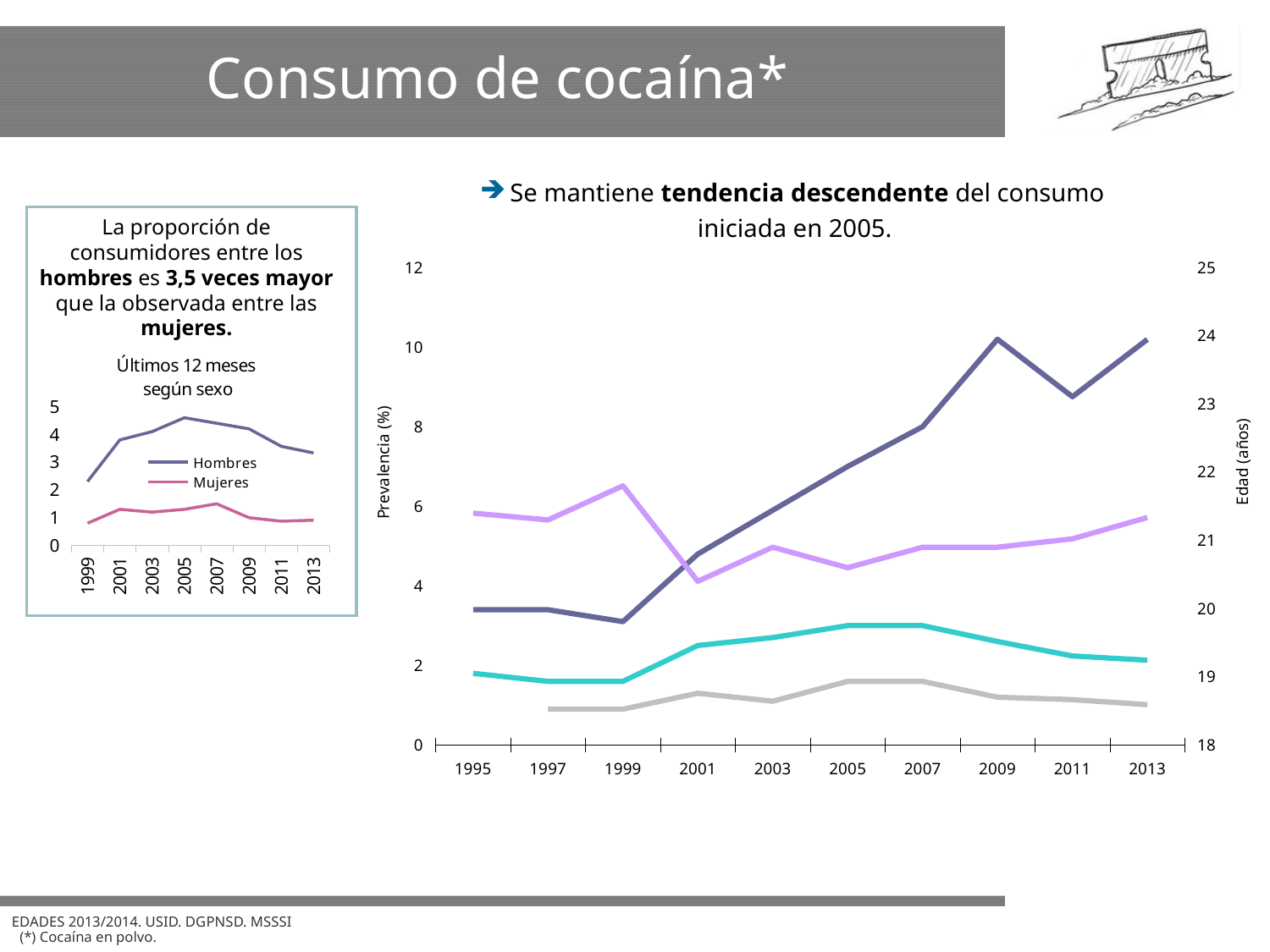
What kind of chart is the large chart on the right of the slide? line chart What kind of chart is the small chart titled 'Últimos 12 meses según sexo'? line chart What is the label of the right-hand vertical axis of the large chart on the right? Edad (años) In the chart 'Últimos 12 meses según sexo', which series has the higher value in 2005, Hombres or Mujeres? Hombres In the chart 'Últimos 12 meses según sexo', is the value for Mujeres in 2007 greater or less than 2? less How many year labels are shown on the x axis of the chart 'Últimos 12 meses según sexo'? 8 In the chart 'Últimos 12 meses según sexo', is the value for Hombres in 1999 greater or less than 3? less How many series does the legend of the chart 'Últimos 12 meses según sexo' list? 2 In the chart 'Últimos 12 meses según sexo', does the Hombres line rise or fall between 2005 and 2013? fall In the chart 'Últimos 12 meses según sexo', is the value for Hombres in 2005 greater or less than 4? greater How many year labels are shown on the x axis of the large chart on the right? 10 What are the two series named in the legend of the chart 'Últimos 12 meses según sexo'? Hombres and Mujeres